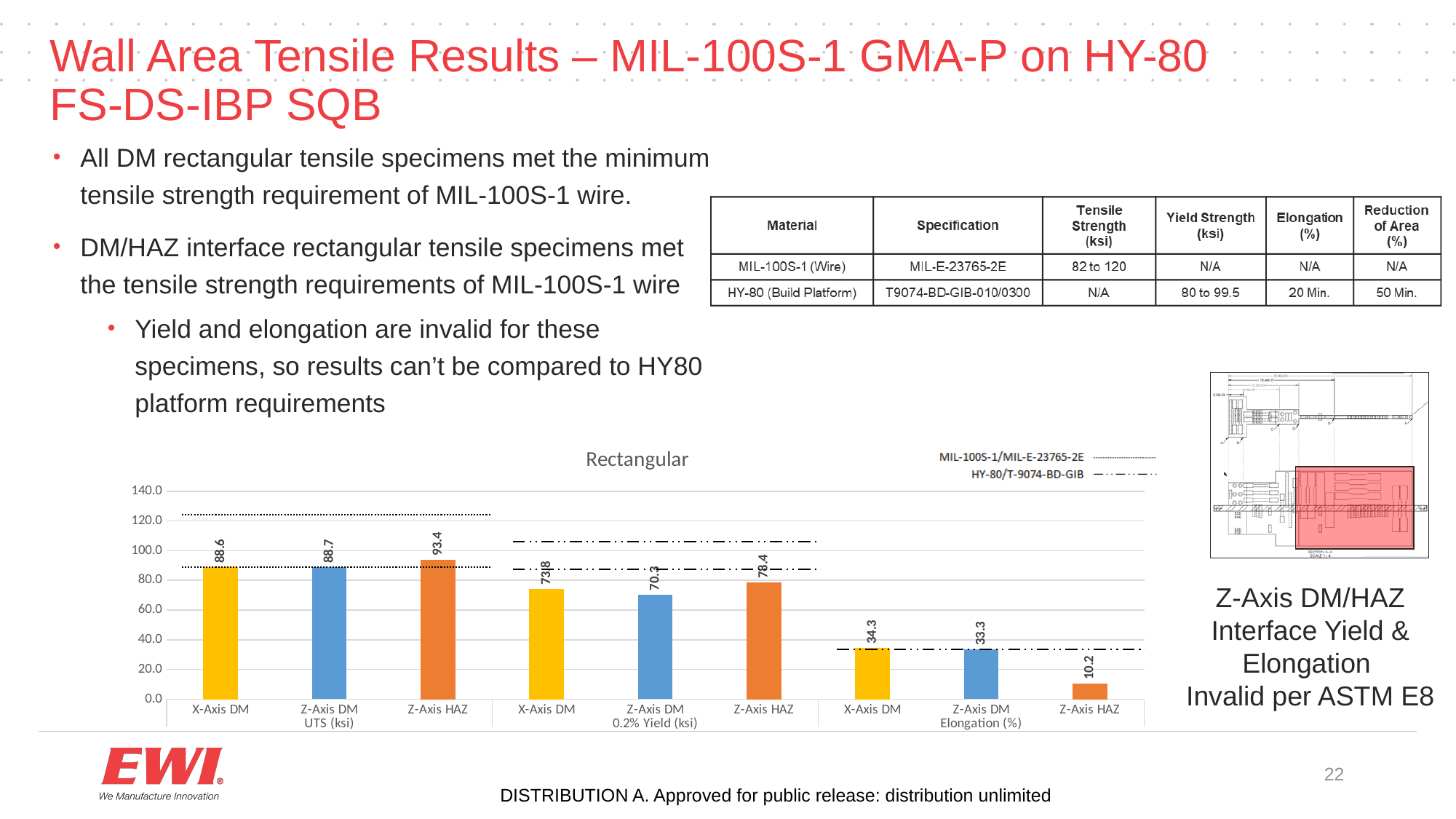
What is the difference between the X-Axis DM and Z-Axis HAZ Elongation (%) values in the Rectangular chart? 24.1 In the Rectangular chart, which is larger: the 0.2% Yield (ksi) for X-Axis DM or for Z-Axis DM? X-Axis DM What is the 0.2% Yield (ksi) value for Z-Axis DM in the Rectangular chart? 70.3 What is the Elongation (%) value for Z-Axis HAZ in the Rectangular chart? 10.2 What is the UTS (ksi) value for Z-Axis HAZ in the Rectangular chart? 93.4 Which specimen has the lowest Elongation (%) in the Rectangular chart? Z-Axis HAZ What is the difference between the Z-Axis HAZ and X-Axis DM UTS (ksi) values in the Rectangular chart? 4.8 Which specimen has the highest 0.2% Yield (ksi) in the Rectangular chart? Z-Axis HAZ What type of chart is the Rectangular chart? bar chart What is the UTS (ksi) value for X-Axis DM in the Rectangular chart? 88.6 How many bars are plotted in the Rectangular chart? 9 What is the title of the bar chart on the slide? Rectangular